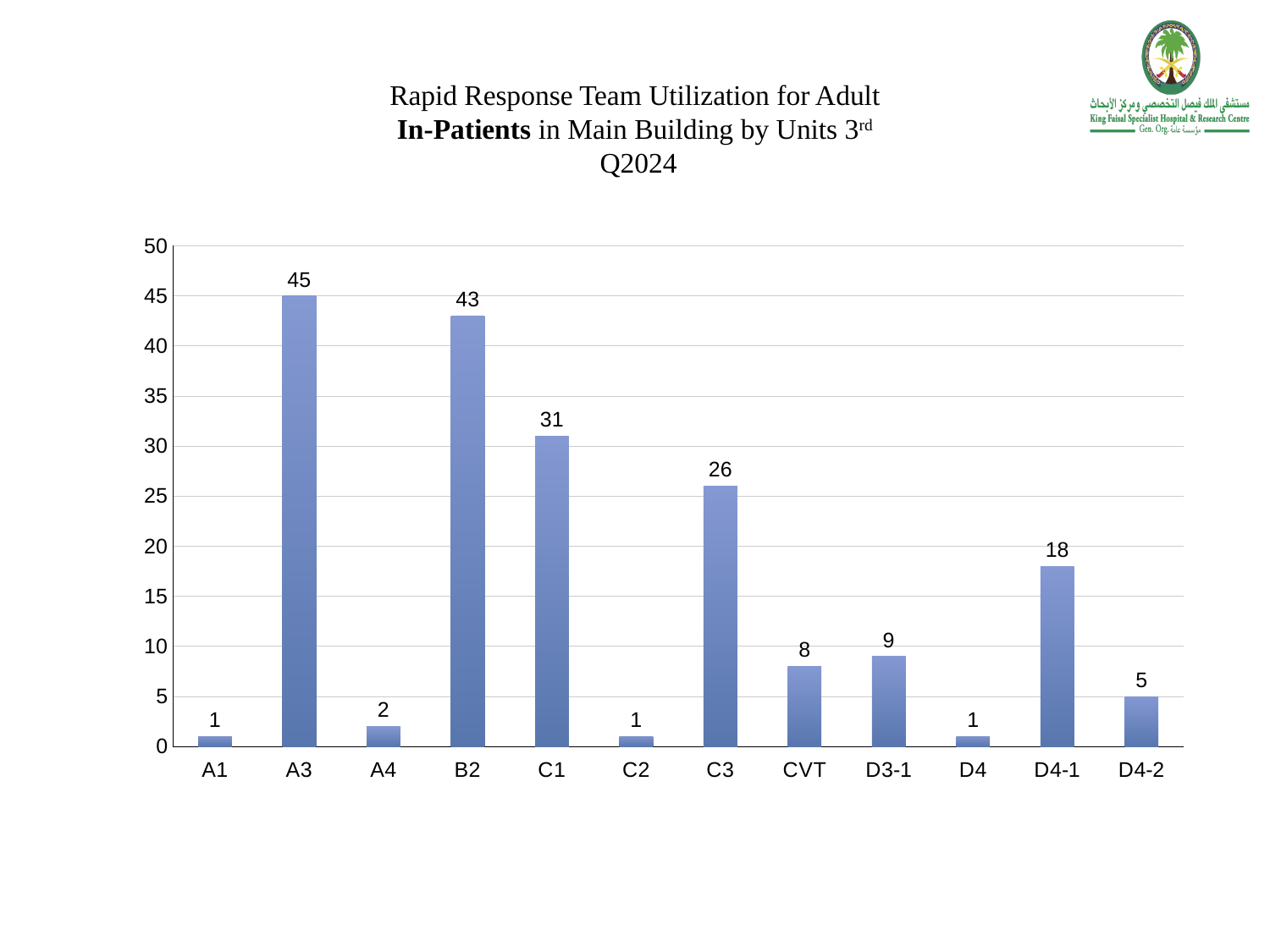
What is the difference between the values for A3 and B2? 2 Is the value for C3 greater or less than 25? greater How many units are shown on the x axis? 12 Which is larger, the value for CVT or the value for D3-1? D3-1 What is the value for unit C1? 31 What is the difference between the values for C1 and C3? 5 What is the value for unit D4-2? 5 What kind of chart is shown on the slide? bar chart Which unit has the highest value? A3 What is the value for unit D4-1? 18 How many units have a value of 1? 3 What is the value for unit A3? 45